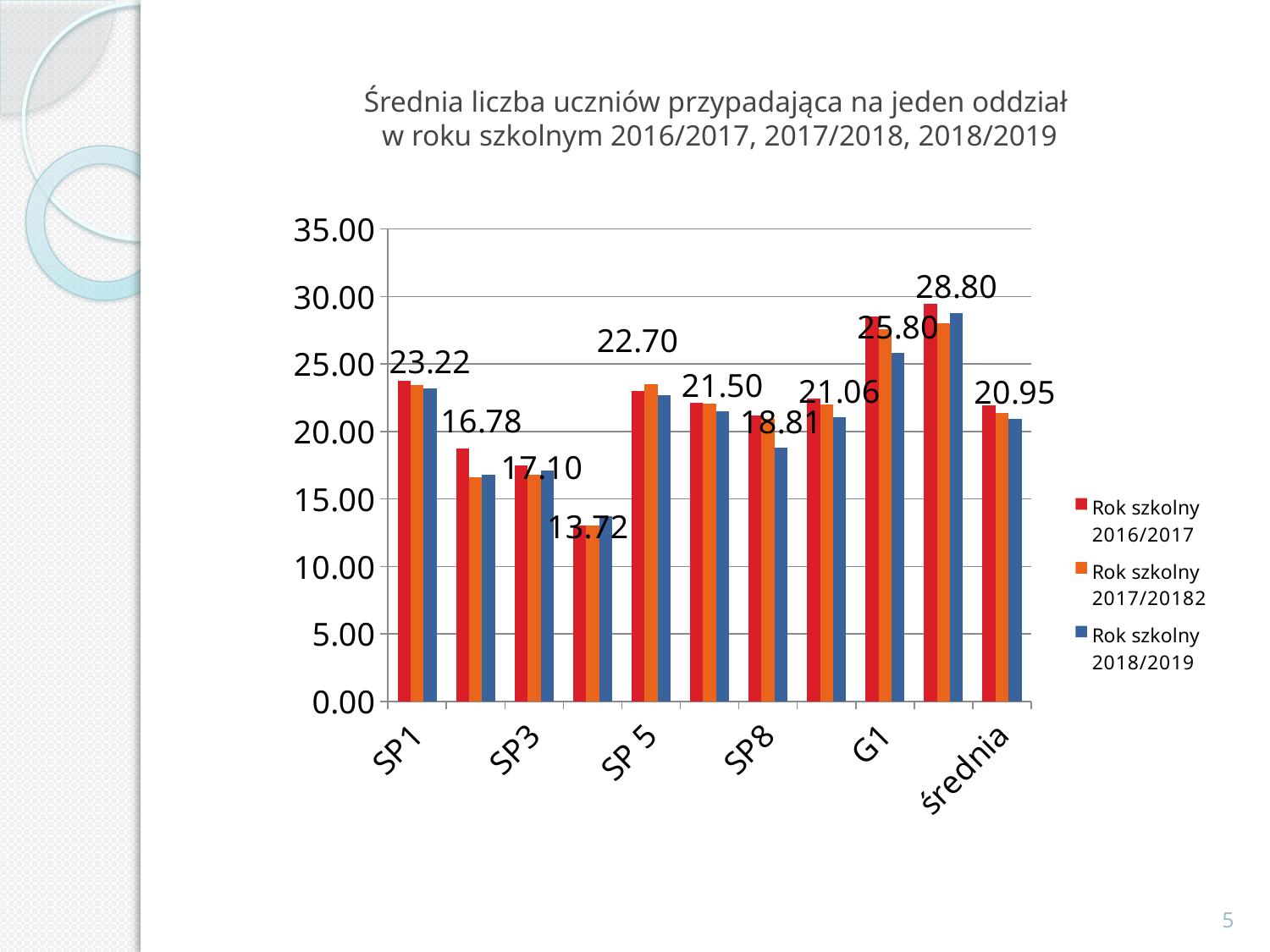
What is the value for SP1 in the Rok szkolny 2018/2019 series? 23.22 What is the difference between the Rok szkolny 2018/2019 values for G1 and SP1? 2.58 What is the highest data label printed on the chart? 28.80 What is the value for SP3 in the Rok szkolny 2018/2019 series? 17.10 In the Rok szkolny 2018/2019 series, which is larger: SP1 or SP8? SP1 Is the Rok szkolny 2016/2017 value for SP3 greater or less than 20.00? less What is the value for SP 5 in the Rok szkolny 2018/2019 series? 22.70 What is the value for średnia in the Rok szkolny 2018/2019 series? 20.95 What kind of chart is shown on the slide? bar chart How many series does the legend list? 3 What is the lowest data label printed on the chart? 13.72 What is the value for G1 in the Rok szkolny 2018/2019 series? 25.80